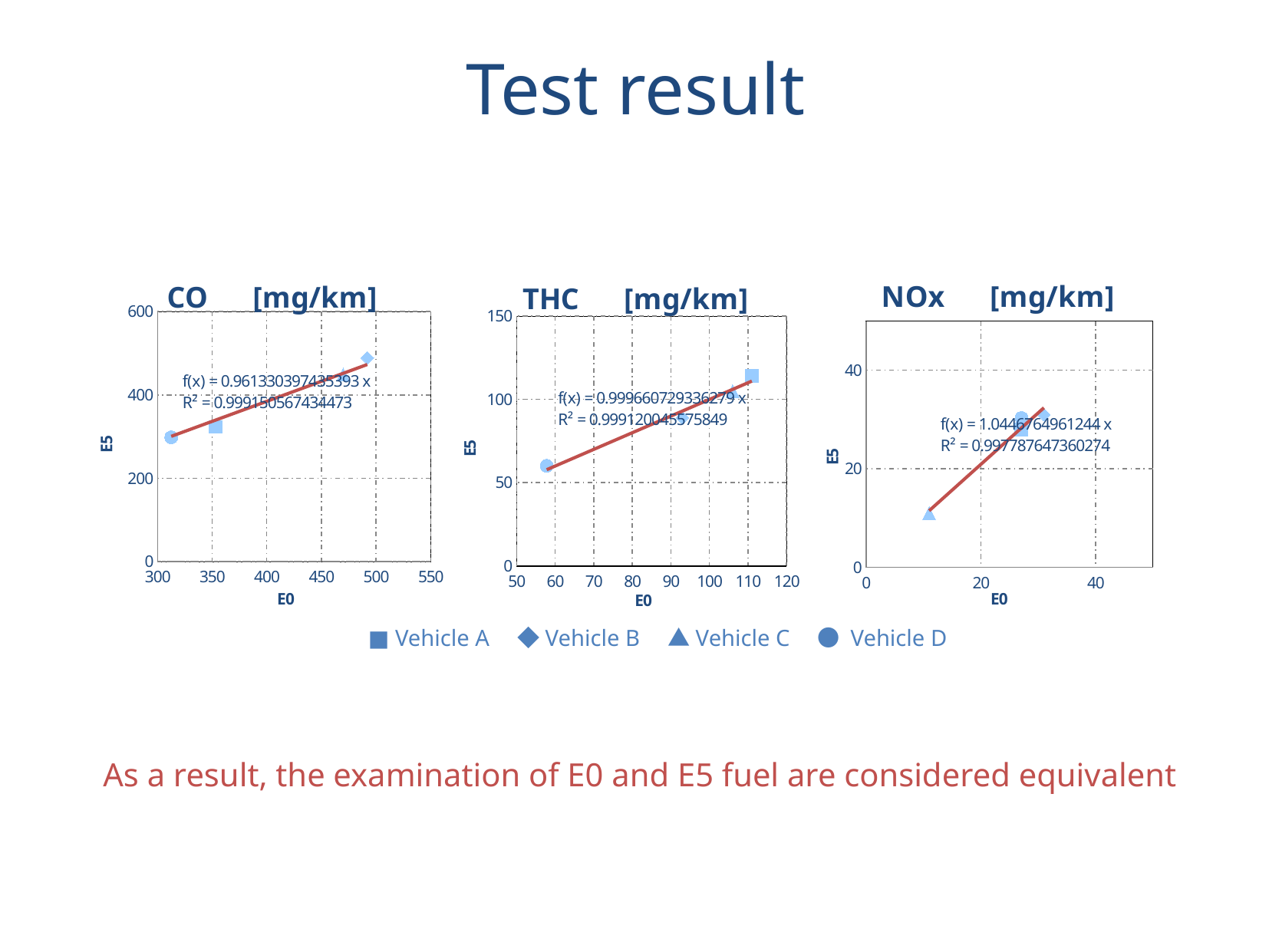
On the NOx [mg/km] chart, which vehicle has the lowest E5 value? Vehicle C How many data points are plotted on the NOx [mg/km] chart? 4 On the NOx [mg/km] chart, is the E5 value for Vehicle C greater or less than 20? less What is the R² value shown on the CO [mg/km] chart? 0.999150567434473 On the CO [mg/km] chart, is the E5 value for Vehicle B greater or less than 400? greater On the THC [mg/km] chart, is the E5 value for Vehicle A greater or less than 100? greater What kind of chart is the CO [mg/km] chart? scatter chart What is the label of the vertical axis on the NOx [mg/km] chart? E5 How many vehicles does the legend list? 4 On the CO [mg/km] chart, which vehicle has the highest E5 value? Vehicle B On the THC [mg/km] chart, do the E5 values rise or fall as E0 increases? rise